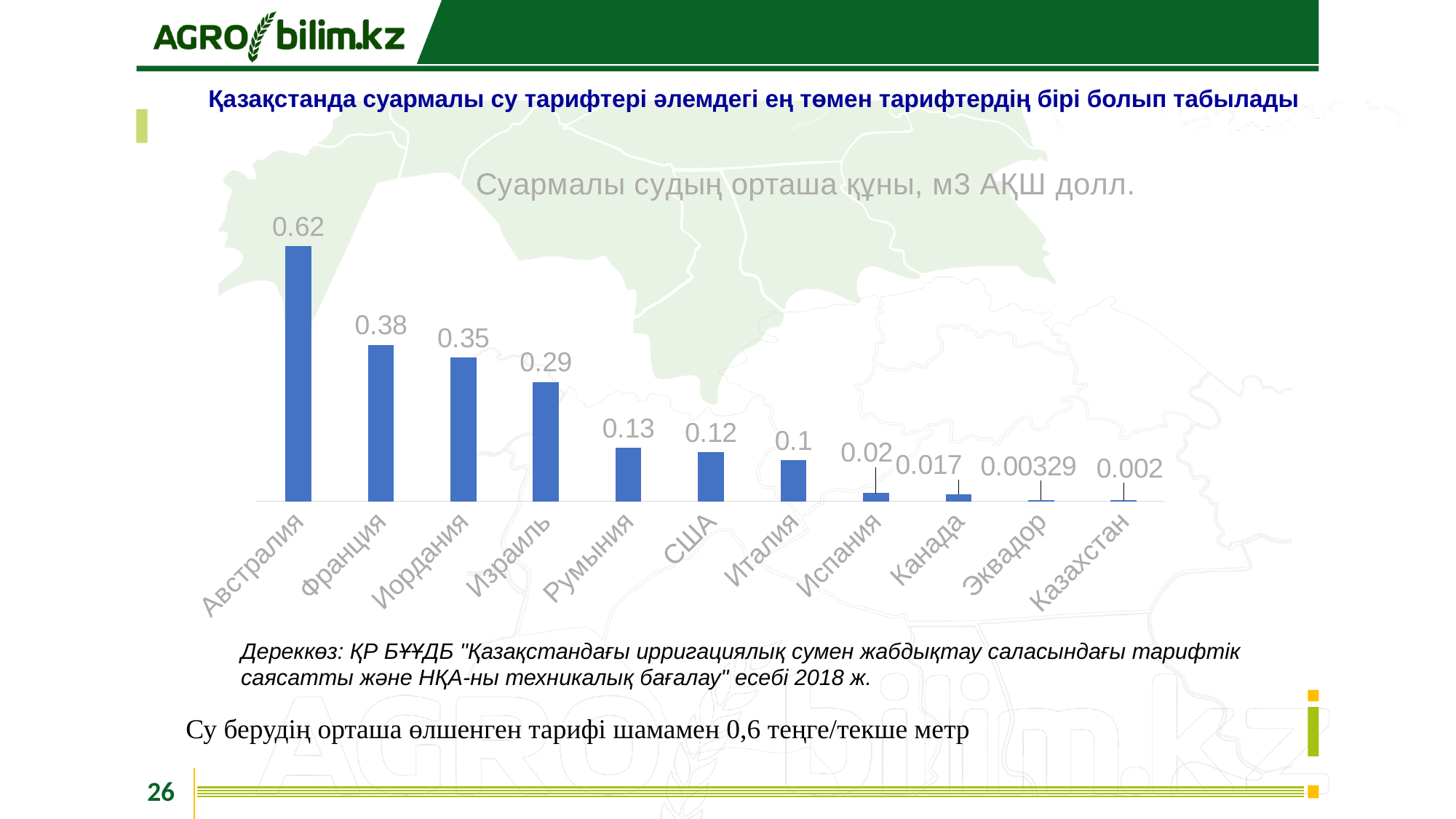
What kind of chart is shown on the slide? bar chart What is the difference between the values for Австралия and Франция? 0.24 How many categories are shown in the chart? 11 Which category has the highest value? Австралия What is the title of the chart? Суармалы судың орташа құны, м3 АҚШ долл. What is the value for Австралия? 0.62 Do the values rise or fall from left to right along the x axis? fall What is the value for Казахстан? 0.002 What is the value for Эквадор? 0.00329 What is the value for Израиль? 0.29 Which is larger, the value for Румыния or the value for США? Румыния Which category has the lowest value? Казахстан